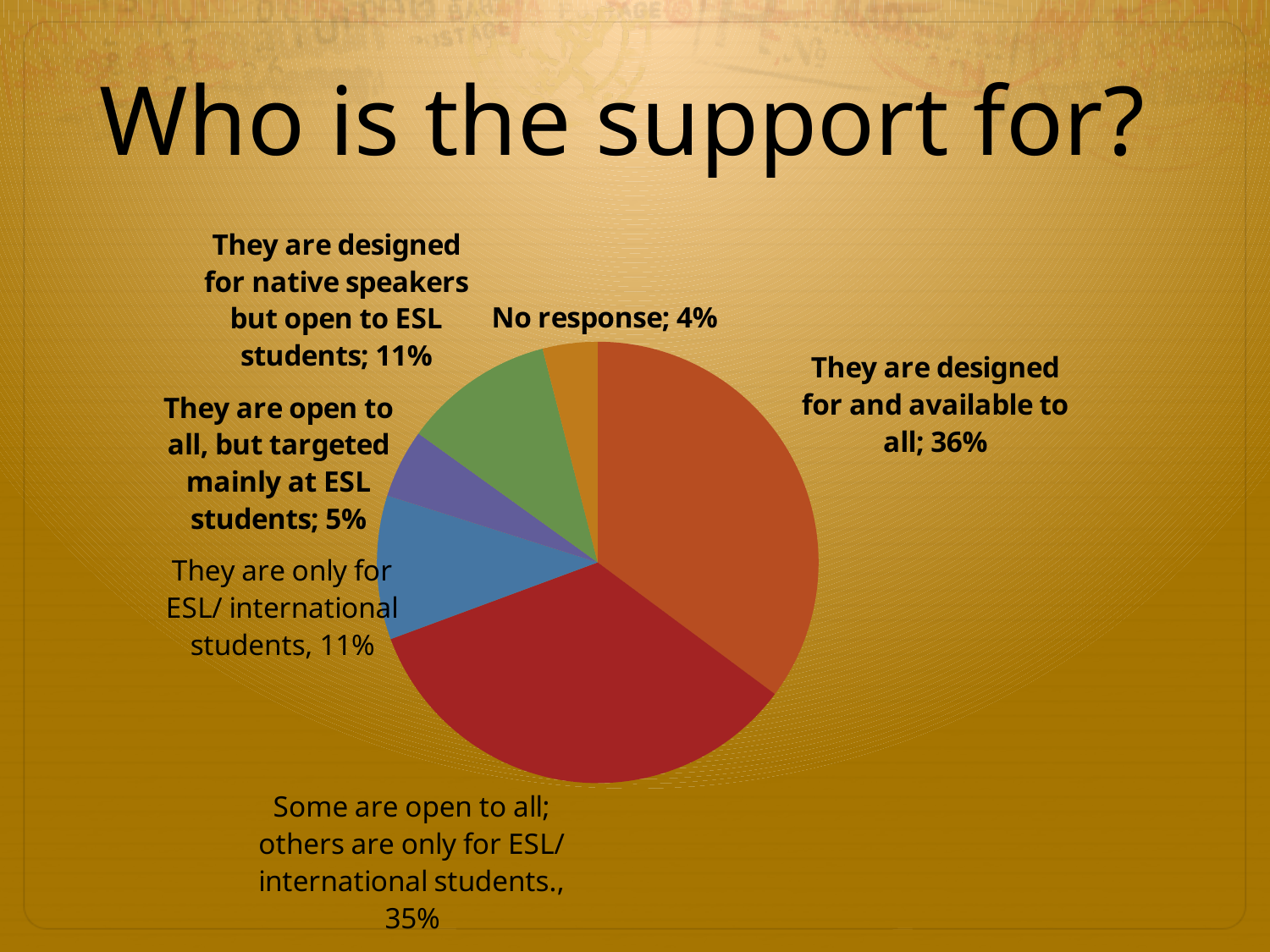
What percentage is shown for 'They are open to all, but targeted mainly at ESL students'? 5% What percentage is shown for 'No response'? 4% What kind of chart is shown on the slide? Pie chart What percentage of the pie is labelled 'They are designed for and available to all'? 36% What is the difference in percentage points between 'They are designed for and available to all' and 'Some are open to all; others are only for ESL/ international students.'? 1 percentage point Which is larger: the share for 'They are designed for native speakers but open to ESL students' or the share for 'They are open to all, but targeted mainly at ESL students'? They are designed for native speakers but open to ESL students What percentage is shown for 'They are only for ESL/ international students'? 11% What is the title of the slide containing the pie chart? Who is the support for? Which category has the smallest share of the pie? No response How many slices does the pie chart have? 6 Which category has the largest share of the pie? They are designed for and available to all What percentage is shown for 'Some are open to all; others are only for ESL/ international students.'? 35%